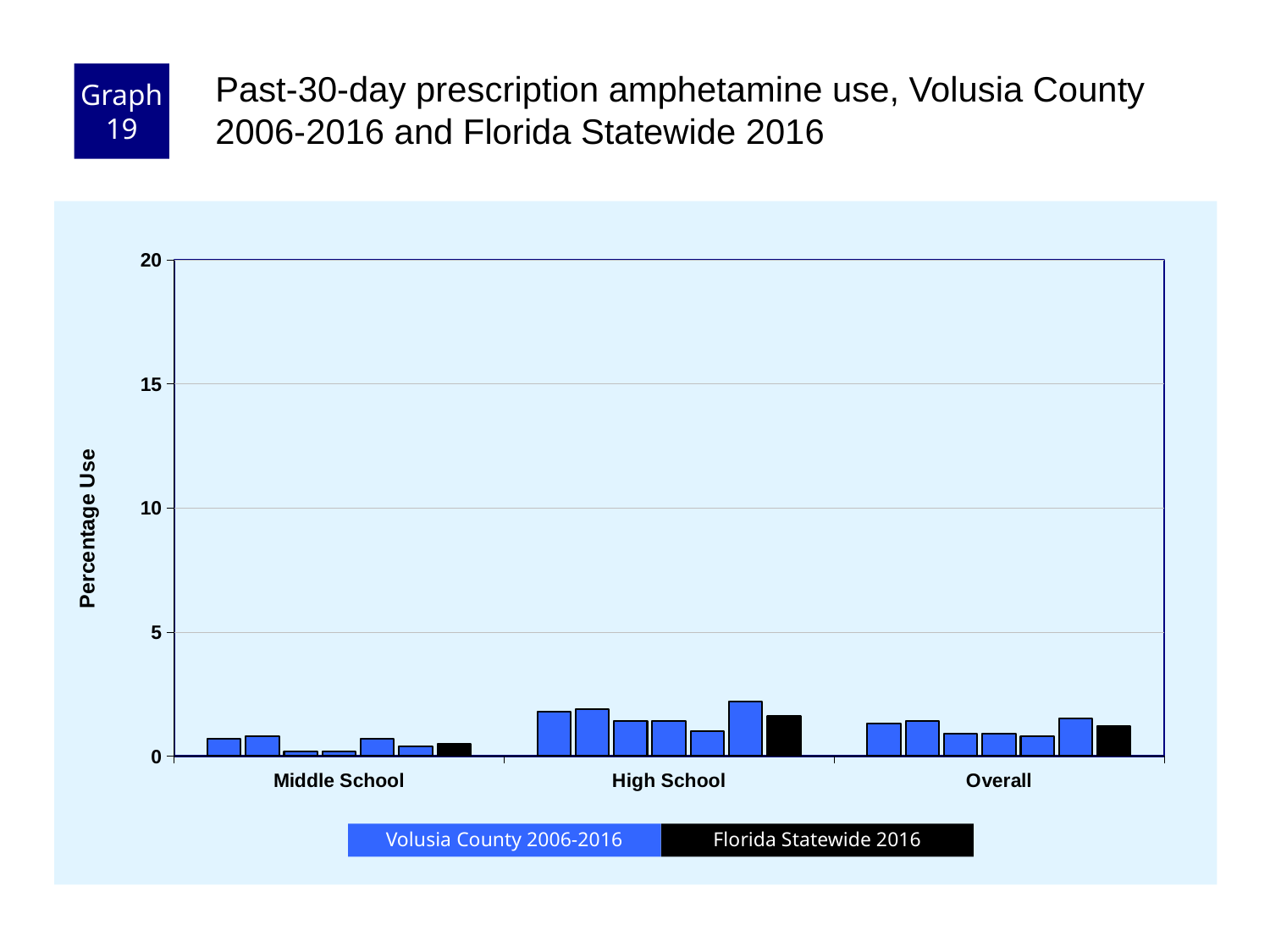
What kind of chart is shown on the slide? bar chart Which is larger, the Florida Statewide 2016 value for Overall or for Middle School? Overall Is the Florida Statewide 2016 value for High School greater or less than 5? less Which is larger, the Florida Statewide 2016 value for High School or for Middle School? High School What is the highest value shown on the y axis of the chart? 20 Is the Florida Statewide 2016 value for Middle School greater or less than 5? less Which category has the highest Florida Statewide 2016 bar? High School What is the label on the y axis of the chart? Percentage Use What colour are the Florida Statewide 2016 bars in the chart? black How many categories are shown on the x axis of the chart? 3 How many series does the chart legend list? 2 Which category has the lowest Florida Statewide 2016 bar? Middle School